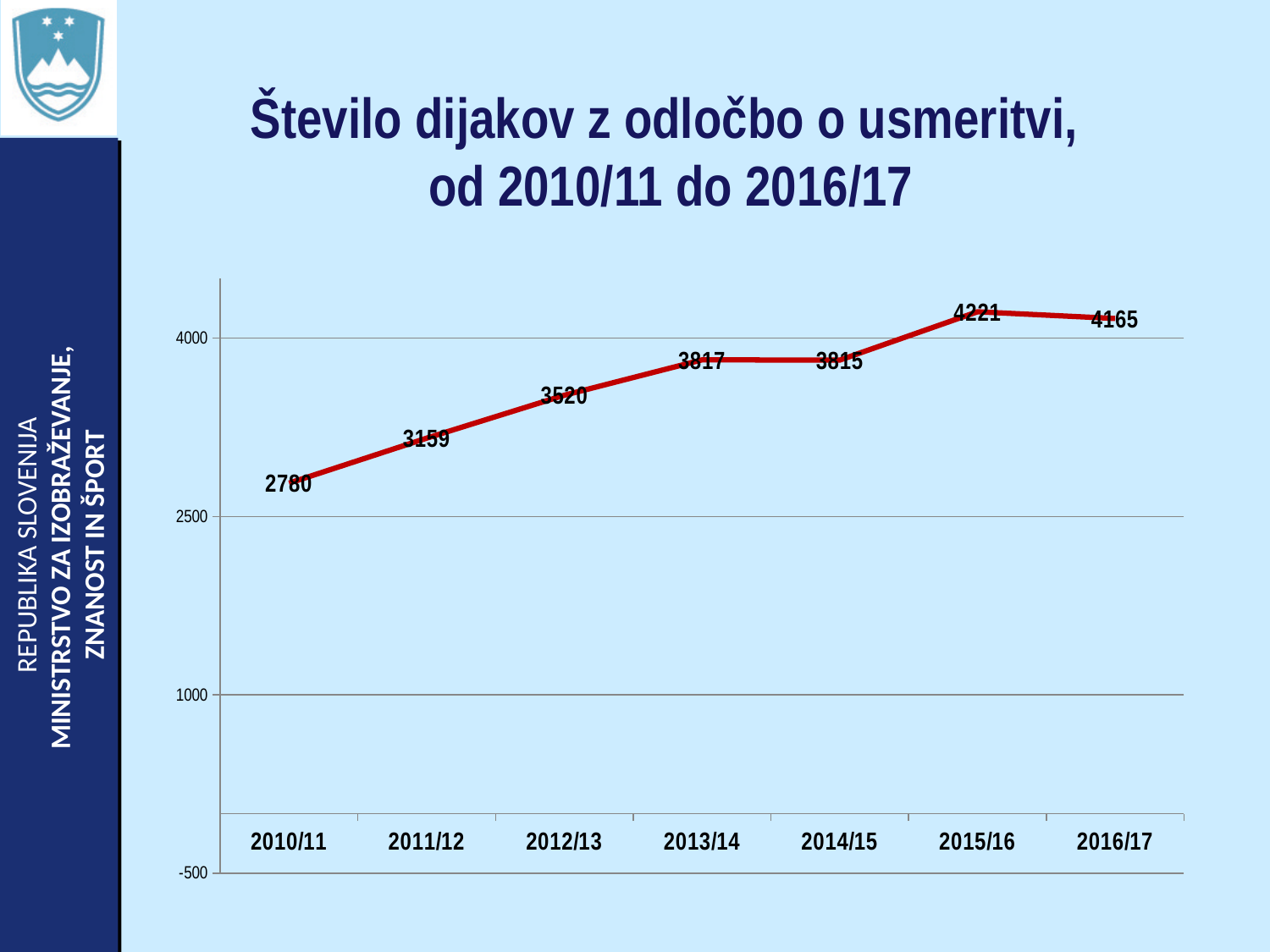
Is the value for 2014/15 greater or less than 4000? less Which school year has the lowest value? 2010/11 Which school year has the highest value? 2015/16 Do the values generally rise or fall from 2010/11 to 2015/16? rise What is the value for 2010/11? 2780 Which is larger, the value for 2015/16 or the value for 2016/17? 2015/16 What is the value for 2013/14? 3817 What kind of chart is shown on the slide? line chart What is the difference between the values for 2015/16 and 2010/11? 1441 What is the difference between the values for 2012/13 and 2011/12? 361 How many school years are plotted on the chart? 7 What is the value for 2016/17? 4165